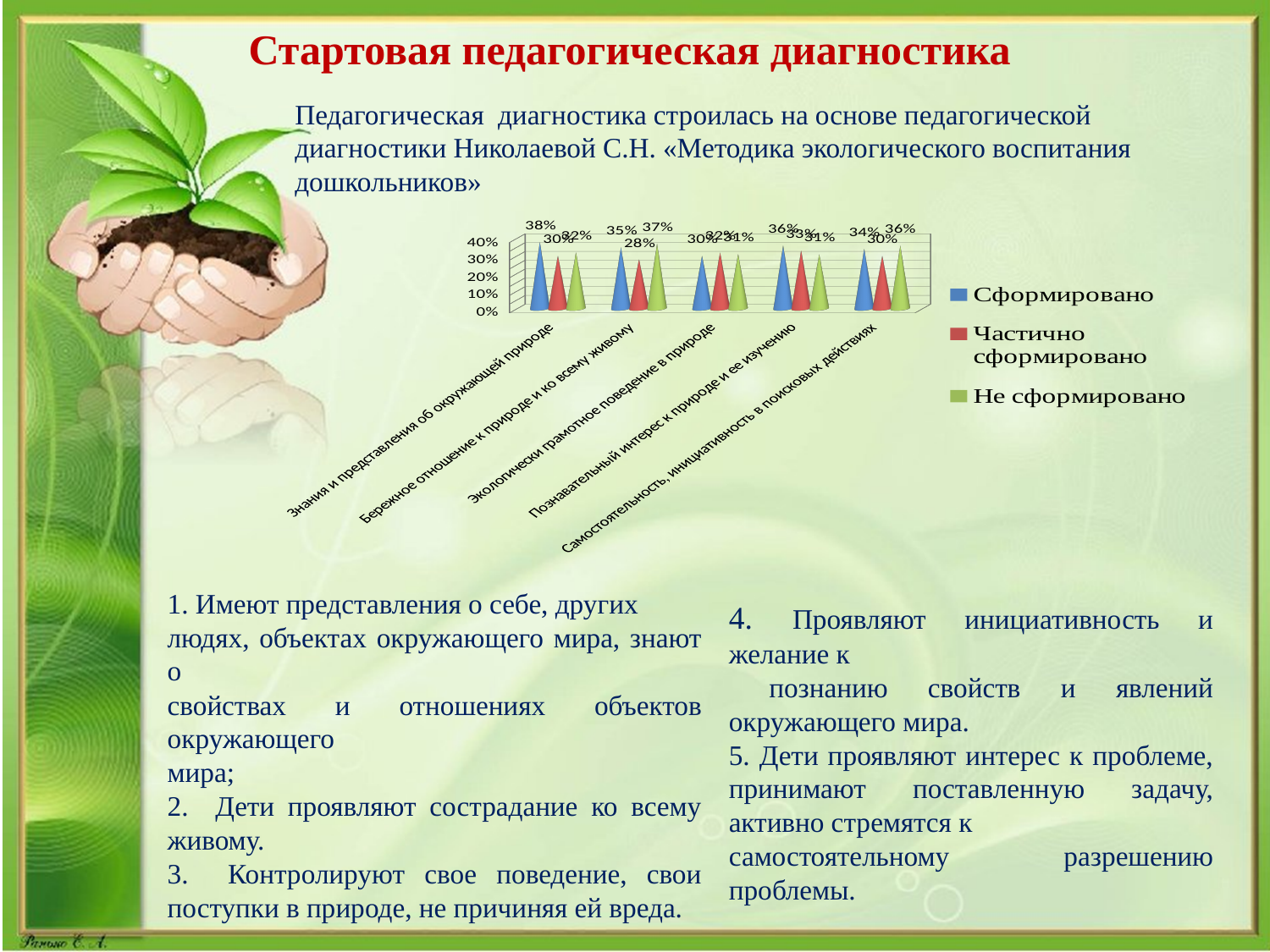
What is the value of «Не сформировано» for «Бережное отношение к природе и ко всему живому»? 37% How many categories are shown on the x axis of the chart? 5 How many series does the chart legend list? 3 Is the value of «Частично сформировано» for «Бережное отношение к природе и ко всему живому» greater or less than 30%? less For «Бережное отношение к природе и ко всему живому», which is larger: «Сформировано» or «Не сформировано»? Не сформировано What colour represents the series «Сформировано» in the chart legend? blue What is the value of «Частично сформировано» for «Бережное отношение к природе и ко всему живому»? 28% Which category has the highest value for «Сформировано»? Знания и представления об окружающей природе For «Знания и представления об окружающей природе», what is the difference between «Сформировано» and «Частично сформировано»? 8% What is the value of «Сформировано» for «Знания и представления об окружающей природе»? 38% What kind of chart is shown on the slide? bar chart What is the value of «Сформировано» for «Самостоятельность, инициативность в поисковых действиях»? 34%